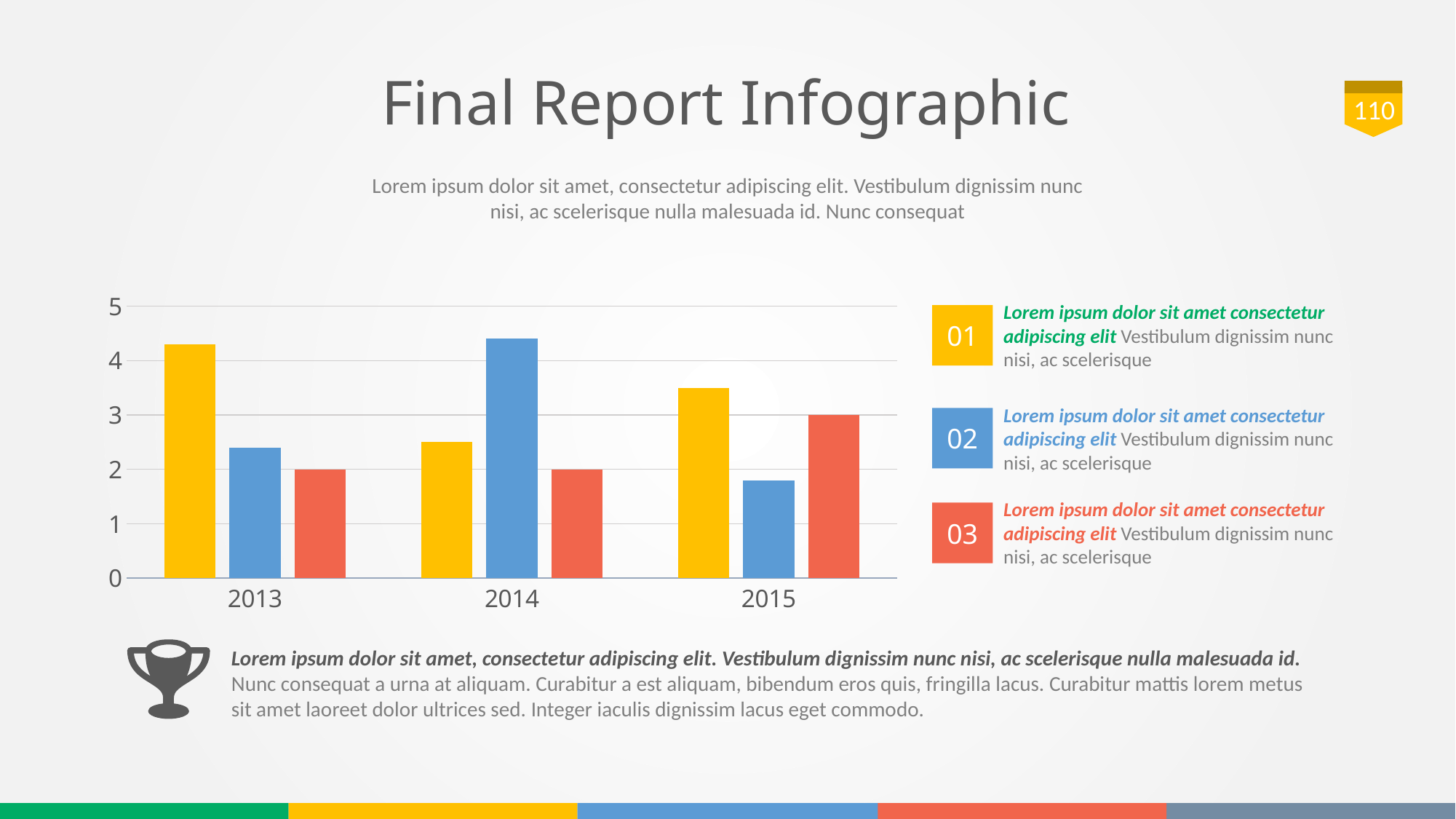
In 2013, which is larger: the yellow bar or the blue bar? yellow Which coloured bar is the highest in the 2014 group? blue Which coloured bar is the lowest in the 2015 group? blue What is the value of the red bar for 2013? 2 What kind of chart is shown on the slide? bar chart Is the value of the yellow bar for 2014 greater or less than 3? less Is the value of the yellow bar for 2013 greater or less than 4? greater What is the value of the red bar for 2015? 3 How many year categories are shown on the x axis of the chart? 3 What is the title of the slide containing the chart? Final Report Infographic Is the value of the blue bar for 2015 greater or less than 2? less What is the difference between the red bar for 2015 and the red bar for 2013? 1